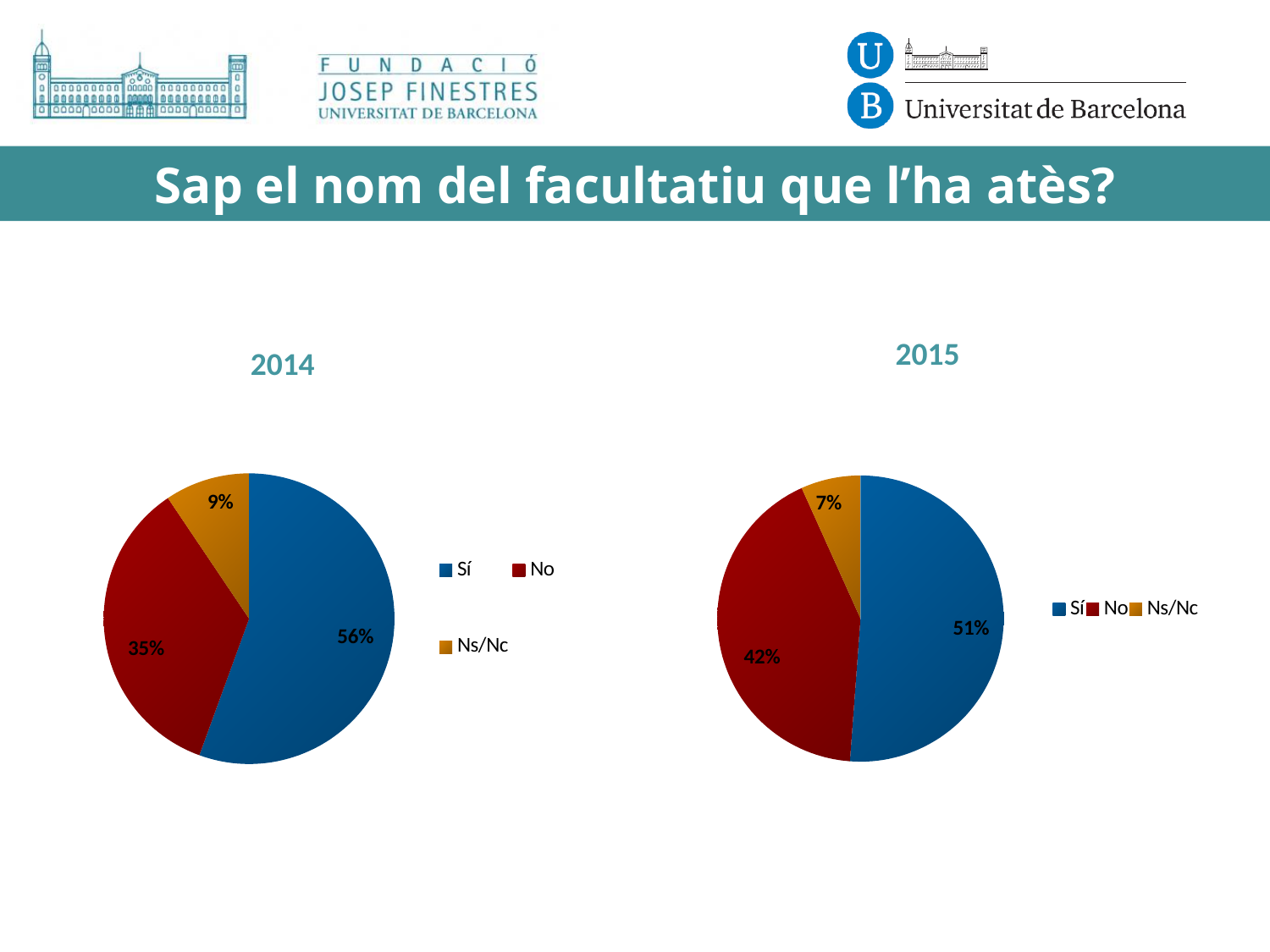
In the 2015 pie chart, what is the difference in percentage points between Sí and No? 9 In the 2014 pie chart, which category has the largest slice? Sí In the 2014 pie chart, what share of respondents answered No? 35% In the 2015 pie chart, what share of respondents answered No? 42% Which is larger: the Ns/Nc share in the 2014 chart or the Ns/Nc share in the 2015 chart? 2014 In the 2014 pie chart, what is the difference in percentage points between Sí and No? 21 In the 2015 pie chart, which category has the smallest slice? Ns/Nc How many categories does the 2015 pie chart show? 3 What colour represents the No category in both pie charts? Red What type of chart is used for the 2014 data? Pie chart In the 2015 pie chart, what share of respondents answered Ns/Nc? 7% In the 2014 pie chart, what share of respondents answered Sí? 56%